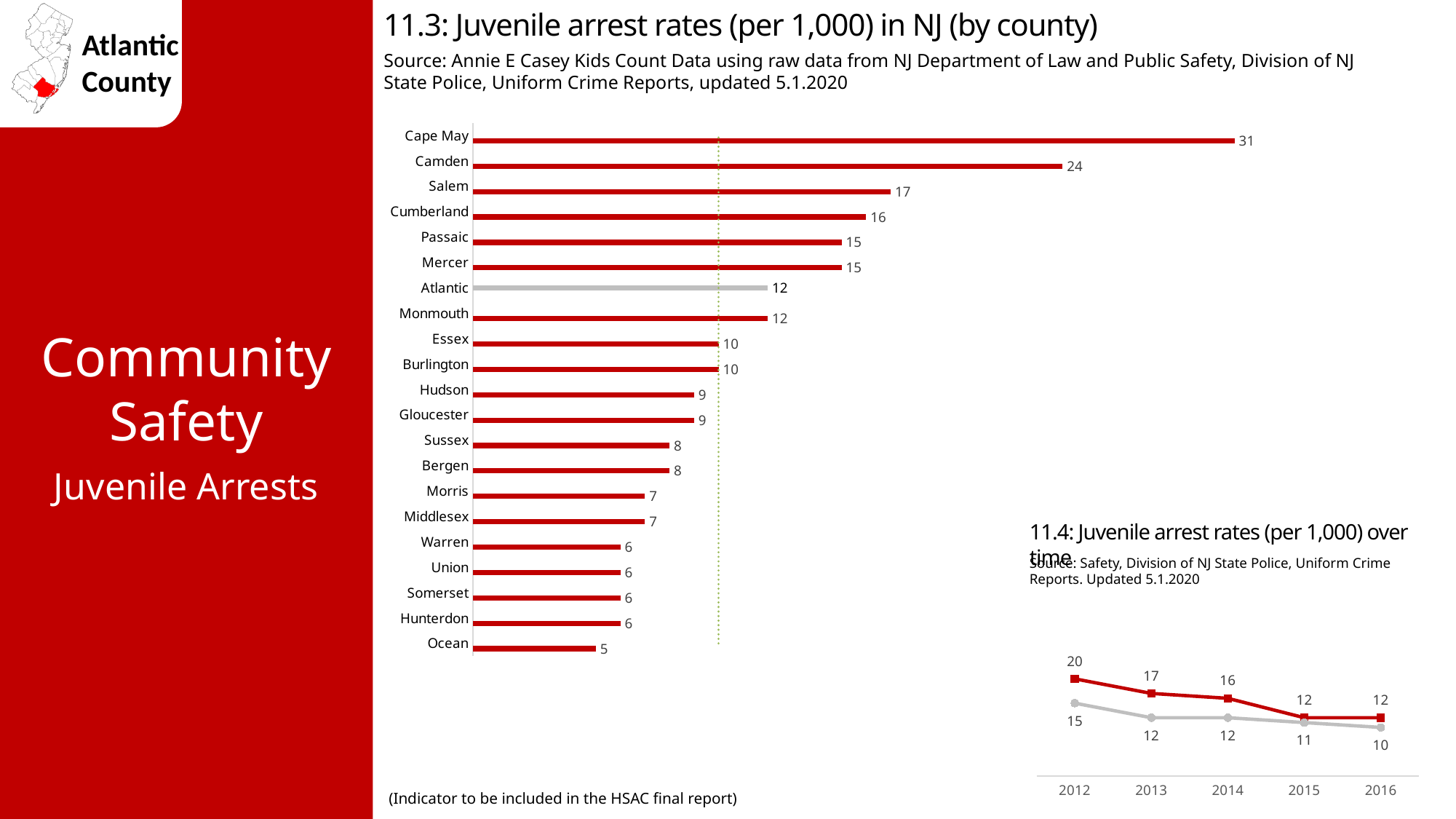
In the chart '11.3: Juvenile arrest rates (per 1,000) in NJ (by county)', which county's bar is coloured gray instead of red? Atlantic In the chart '11.3: Juvenile arrest rates (per 1,000) in NJ (by county)', what is the difference between the values for Cape May and Camden? 7 In the chart '11.4: Juvenile arrest rates (per 1,000) over time', do the values of the red line rise or fall from 2012 to 2016? Fall How many counties are shown in the chart '11.3: Juvenile arrest rates (per 1,000) in NJ (by county)'? 21 In the chart '11.3: Juvenile arrest rates (per 1,000) in NJ (by county)', which county has the highest juvenile arrest rate? Cape May In the chart '11.3: Juvenile arrest rates (per 1,000) in NJ (by county)', what is the value for Atlantic? 12 In the chart '11.4: Juvenile arrest rates (per 1,000) over time', what is the value of the gray line in 2016? 10 In the chart '11.3: Juvenile arrest rates (per 1,000) in NJ (by county)', which has a higher value, Salem or Passaic? Salem In the chart '11.3: Juvenile arrest rates (per 1,000) in NJ (by county)', which county has the lowest juvenile arrest rate? Ocean In the chart '11.3: Juvenile arrest rates (per 1,000) in NJ (by county)', what is the value for Cape May? 31 What kind of chart is '11.3: Juvenile arrest rates (per 1,000) in NJ (by county)'? Bar chart In the chart '11.4: Juvenile arrest rates (per 1,000) over time', what is the value of the red line in 2012? 20